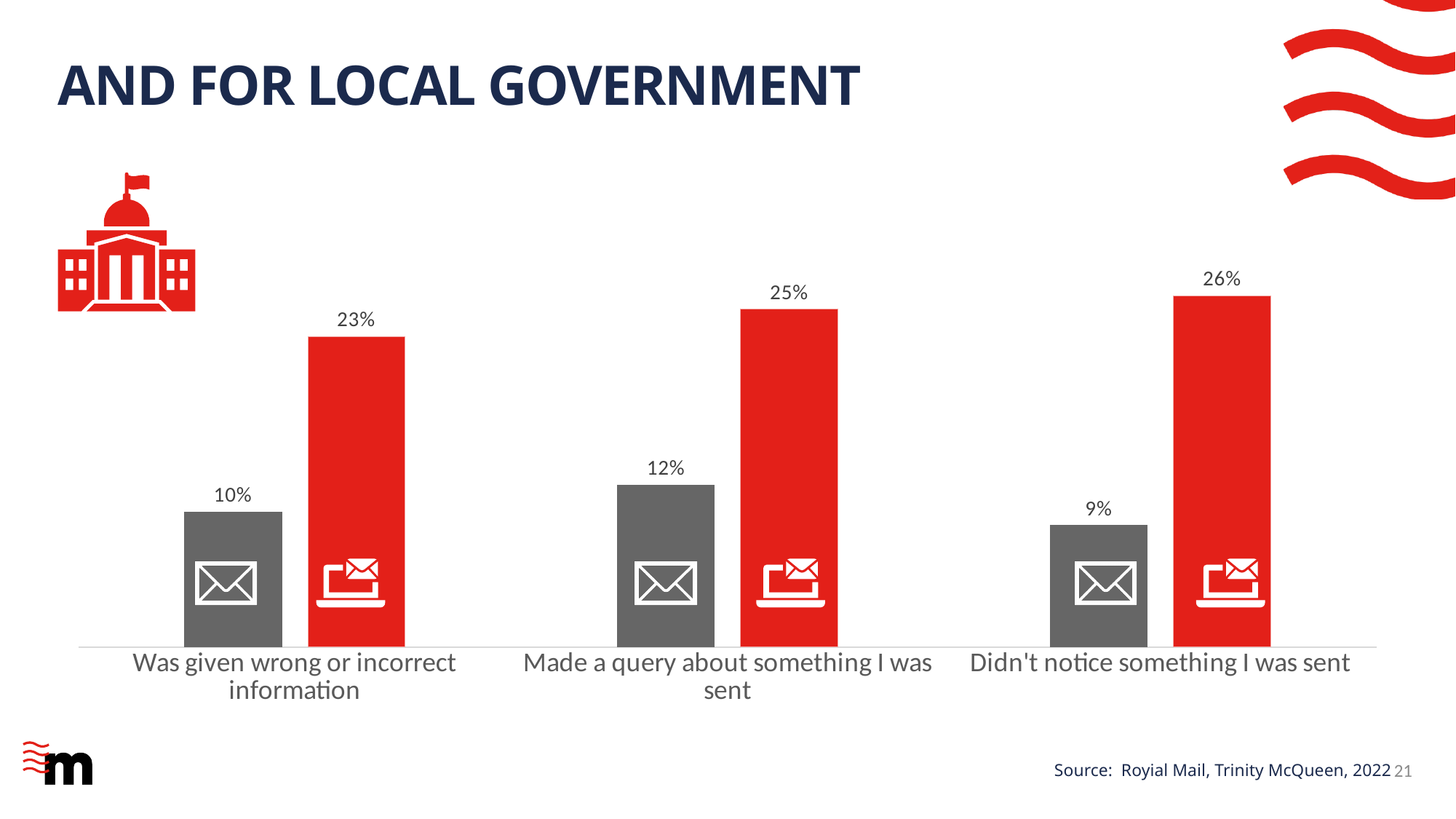
What is the title of the slide? AND FOR LOCAL GOVERNMENT What is the difference between the red and grey bars for 'Made a query about something I was sent'? 13% What is the difference between the red and grey bars for 'Didn't notice something I was sent'? 17% What is the value of the grey bar for 'Was given wrong or incorrect information'? 10% What kind of chart is shown on the slide? bar chart What is the value of the red bar for 'Didn't notice something I was sent'? 26% How many categories are shown along the x axis? 3 What is the value of the red bar for 'Was given wrong or incorrect information'? 23% What is the value of the grey bar for 'Made a query about something I was sent'? 12% Which category has the highest red bar? Didn't notice something I was sent Which is larger for 'Was given wrong or incorrect information': the grey bar or the red bar? the red bar Which category has the lowest grey bar? Didn't notice something I was sent